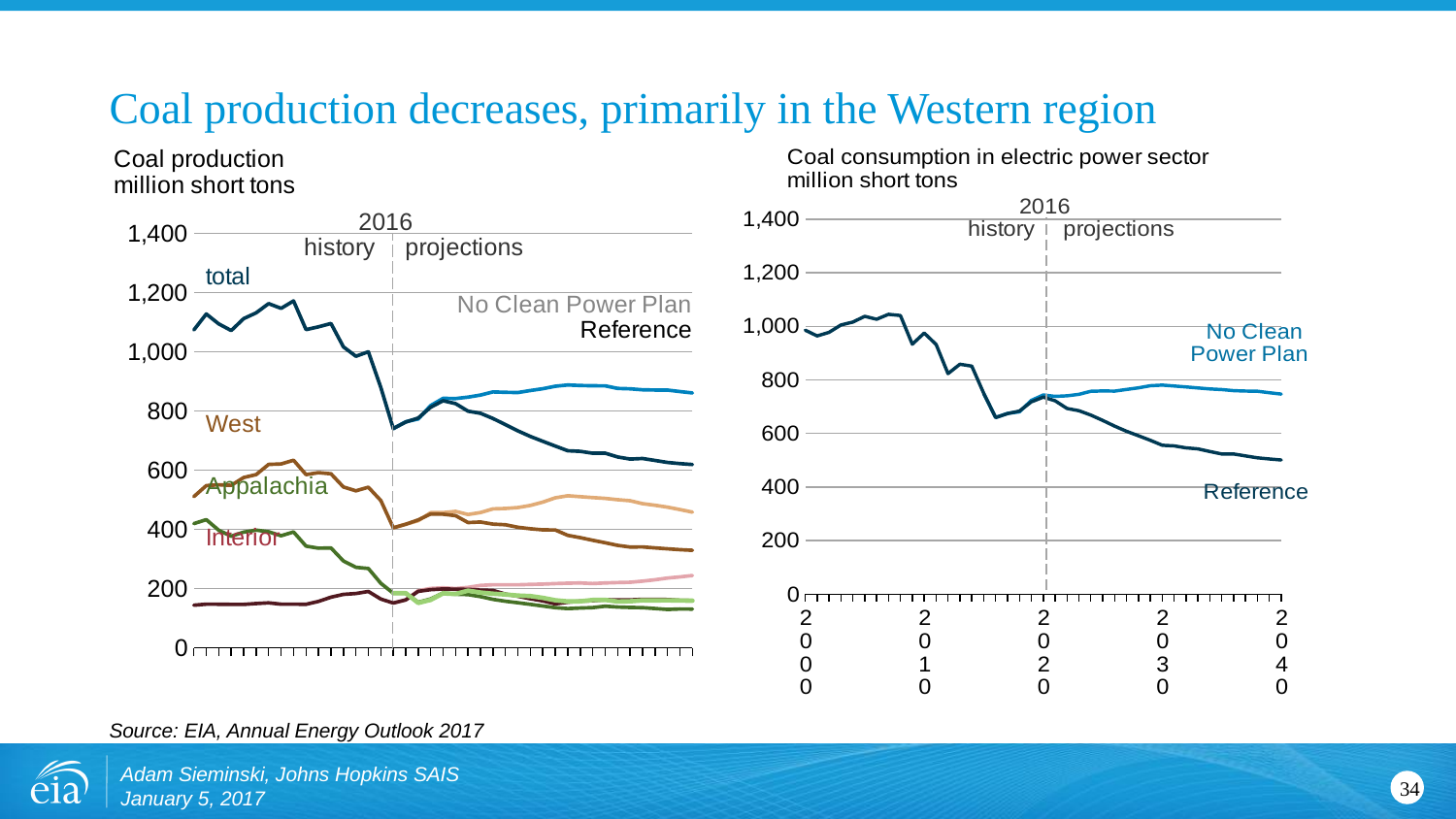
In the 'Coal consumption in electric power sector' chart, is the No Clean Power Plan value in 2040 greater or less than 600? greater In the 'Coal production' chart, does total coal production rise or fall over the history period from 2000 to 2016? fall In the 'Coal production' chart, which region has the lowest production in 2000? Interior In the 'Coal production' chart, which region has the highest production in 2000? West In the 'Coal production' chart, is the total production in 2000 greater or less than 1,000? greater In the 'Coal consumption in electric power sector' chart, does consumption under the Reference case rise or fall from 2016 to 2040? fall Which year separates history from projections in both charts? 2016 In the 'Coal production' chart, is the Reference total production in 2040 greater or less than 800? less What kind of chart is the 'Coal consumption in electric power sector' chart on the right? line chart In the 'Coal consumption in electric power sector' chart, which scenario shows higher consumption in 2040, No Clean Power Plan or Reference? No Clean Power Plan What kind of chart is the 'Coal production' chart on the left? line chart